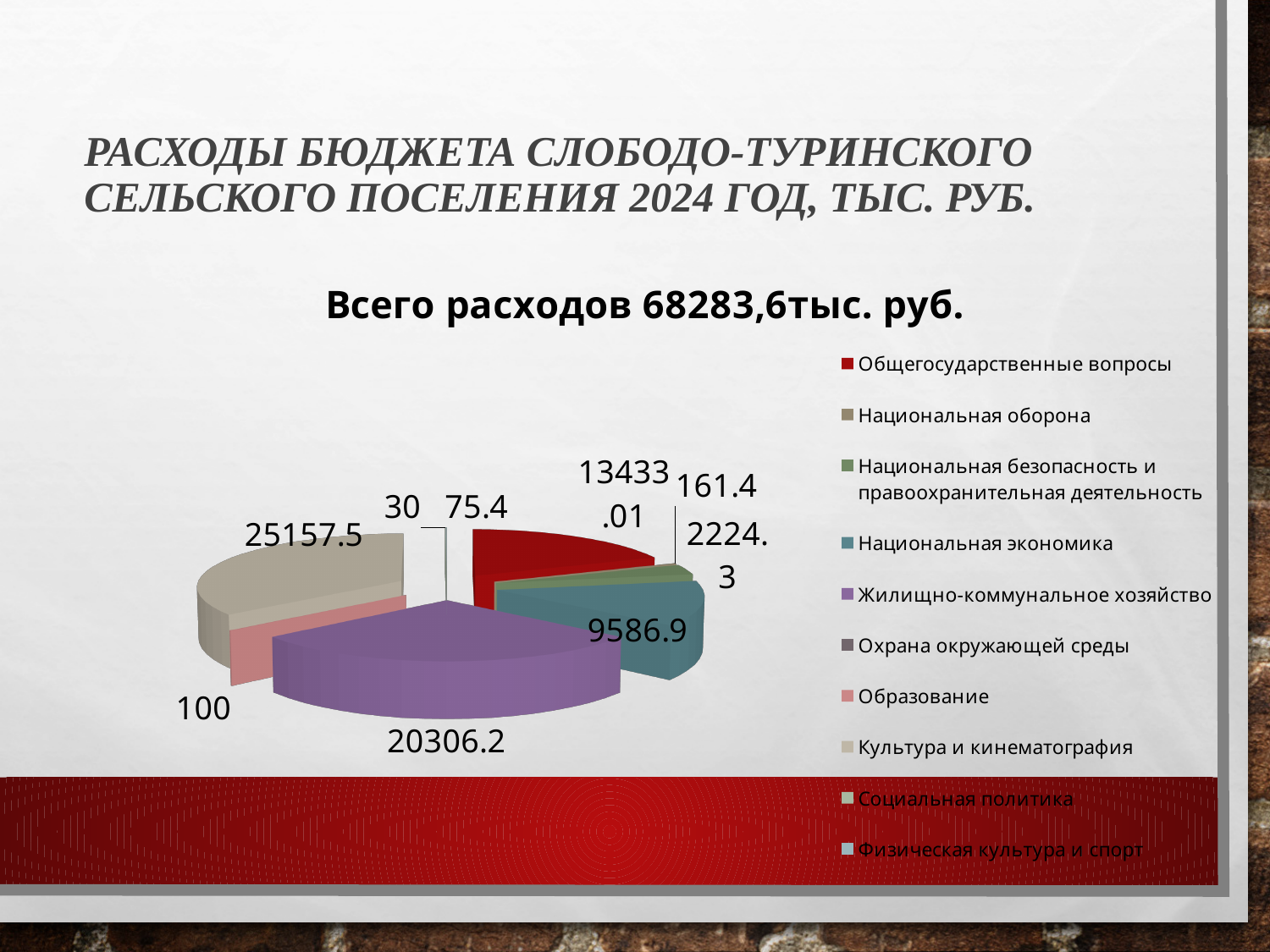
What is the value for Национальная безопасность и правоохранительная деятельность? 2224.3 What is the value for Национальная экономика? 9586.9 How many categories does the chart legend list? 10 What is the title of the chart? Всего расходов 68283,6тыс. руб. What is the difference between Культура и кинематография and Жилищно-коммунальное хозяйство? 4851.3 What is the value for Жилищно-коммунальное хозяйство? 20306.2 What is the value for Общегосударственные вопросы? 13433.01 What is the value for Культура и кинематография? 25157.5 Which is larger, Жилищно-коммунальное хозяйство or Национальная экономика? Жилищно-коммунальное хозяйство What is the difference between Жилищно-коммунальное хозяйство and Национальная экономика? 10719.3 What kind of chart is shown on the slide? pie chart Which category has the largest slice of the pie? Культура и кинематография